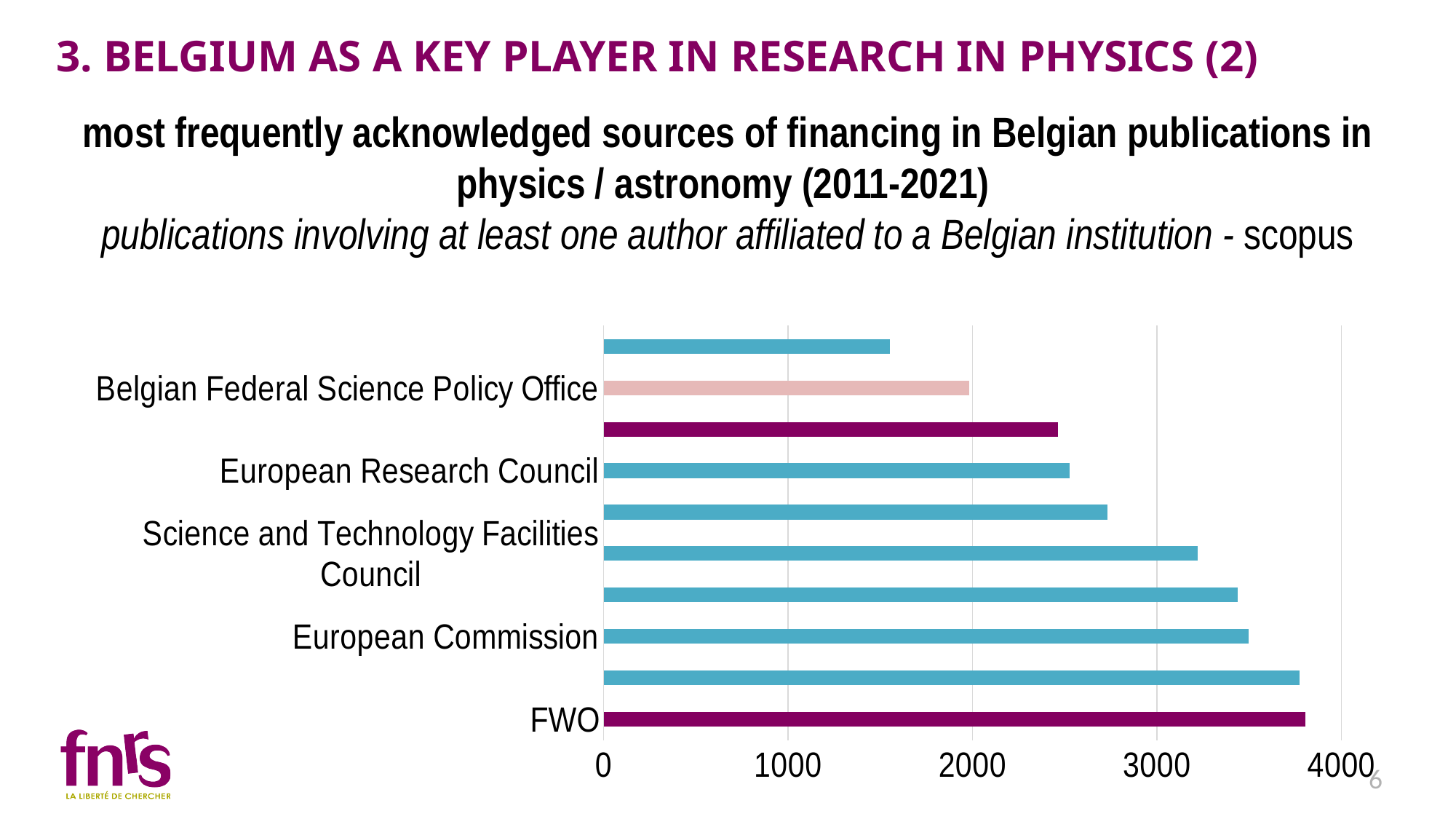
Which category has the highest value in the chart? FWO Is the value for European Commission greater or less than 4000? less Is the value for Science and Technology Facilities Council greater or less than 3000? greater What colour is the bar for FWO? purple Which is larger, the value for European Research Council or the value for Science and Technology Facilities Council? Science and Technology Facilities Council What colour is the bar for Belgian Federal Science Policy Office? pink Is the value for Belgian Federal Science Policy Office greater or less than 3000? less What kind of chart is shown on the slide? bar chart Which is larger, the value for FWO or the value for European Commission? FWO How many bars are plotted in the chart? 10